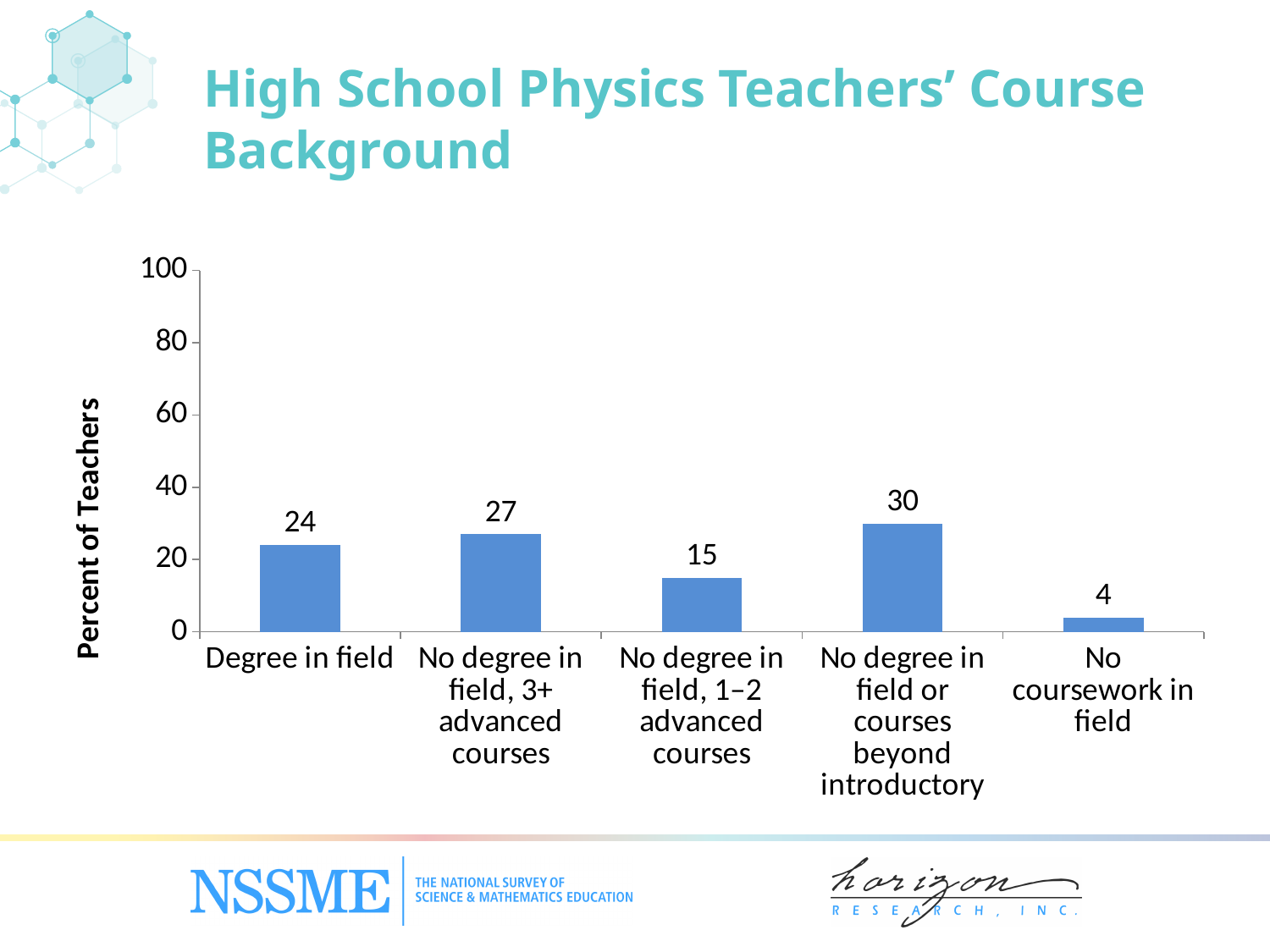
What is the title of the slide? High School Physics Teachers' Course Background What is the difference between 'No degree in field, 3+ advanced courses' and 'Degree in field'? 3 What kind of chart is shown on the slide? Bar chart What is the label of the y axis? Percent of Teachers Which is larger: 'No degree in field, 1–2 advanced courses' or 'No degree in field or courses beyond introductory'? No degree in field or courses beyond introductory Which category has the highest percent of teachers? No degree in field or courses beyond introductory Which category has the lowest percent of teachers? No coursework in field What percent of teachers have no coursework in field? 4 Is the value for 'Degree in field' greater or less than 40? less How many categories are shown on the x axis? 5 What is the value for 'No degree in field, 1–2 advanced courses'? 15 What percent of teachers have a degree in field? 24